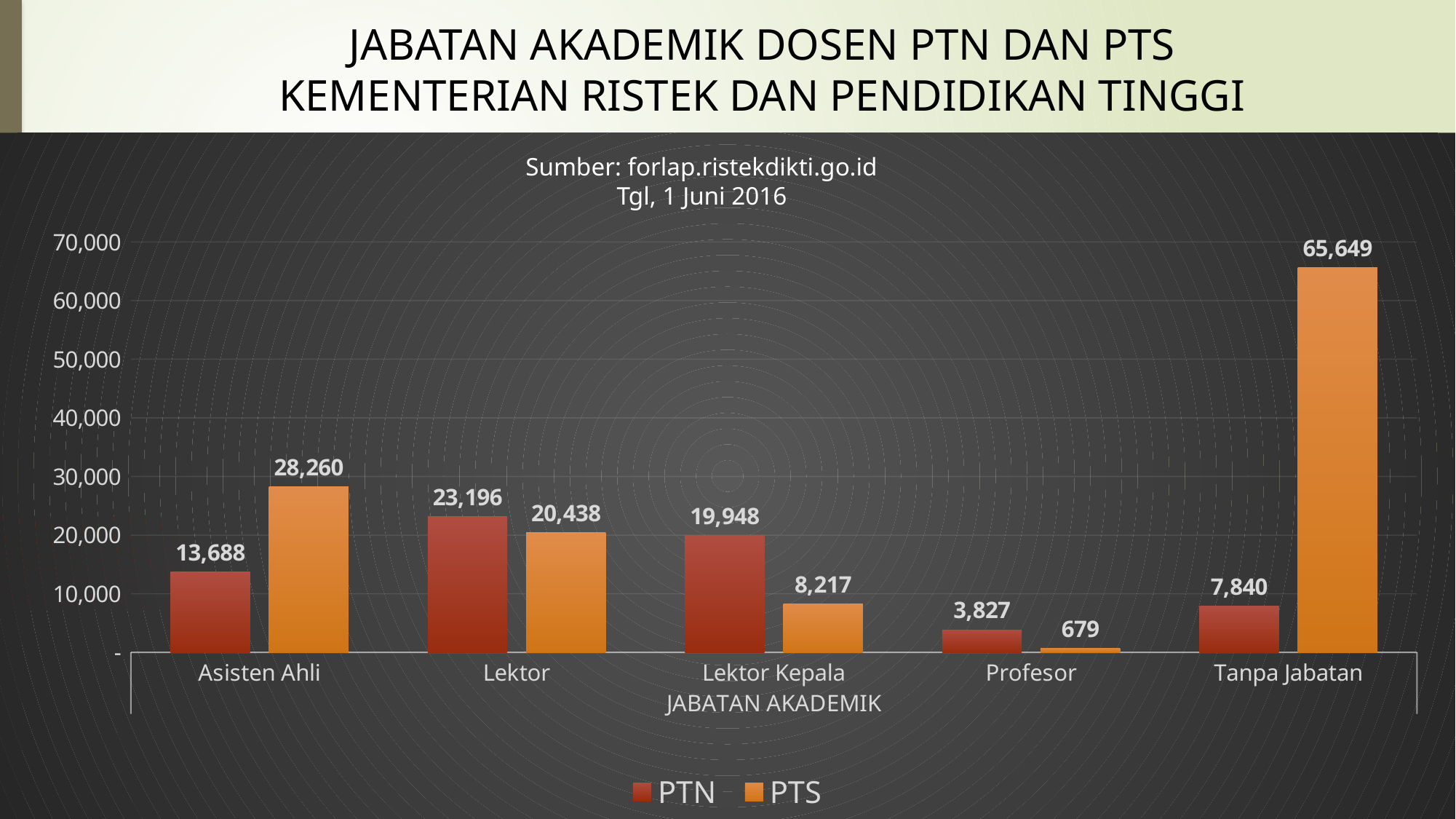
What is the title of the x axis? JABATAN AKADEMIK Which category has the lowest PTS value? Profesor How many series does the legend list? 2 What is the PTS value for Tanpa Jabatan? 65,649 Which is larger for Lektor Kepala, the PTN value or the PTS value? PTN What is the PTN value for Lektor? 23,196 Is the PTS value for Tanpa Jabatan greater or less than 60,000? greater What kind of chart is shown on the slide? Bar chart Which category has the highest PTN value? Lektor How many categories are shown on the x axis? 5 What is the difference between the PTS and PTN values for Asisten Ahli? 14,572 What is the PTS value for Profesor? 679